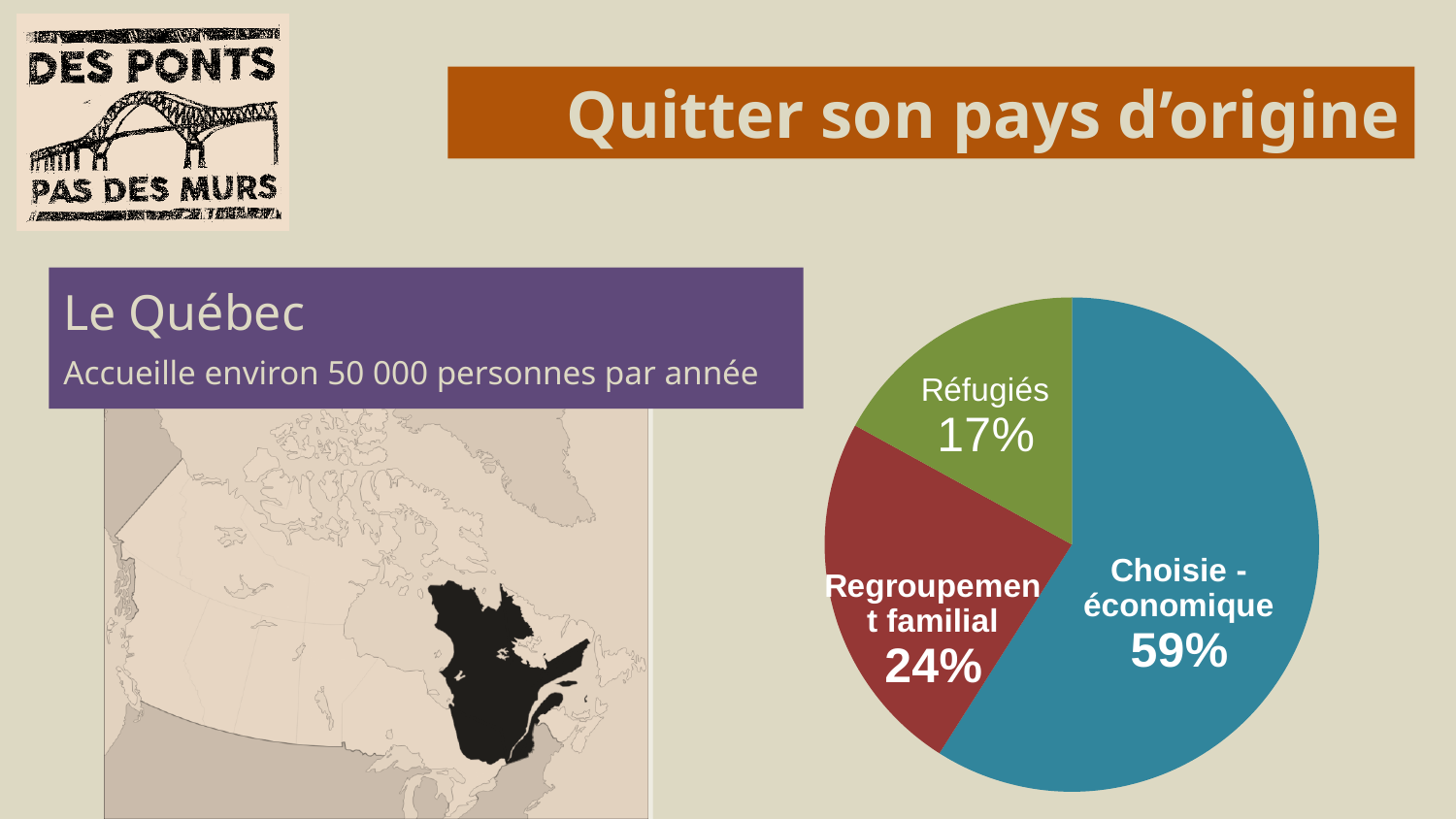
What share of the pie does the 'Réfugiés' slice represent? 17% What share of the pie does the 'Choisie - économique' slice represent? 59% What colour is the 'Choisie - économique' slice of the pie chart? blue What is the difference in percentage points between 'Regroupement familial' and 'Réfugiés'? 7 Which is larger, the 'Regroupement familial' slice or the 'Réfugiés' slice? Regroupement familial What kind of chart is shown on the slide? pie chart Which slice of the pie chart is the smallest? Réfugiés How many slices does the pie chart have? 3 What is the difference in percentage points between 'Choisie - économique' and 'Regroupement familial'? 35 What share of the pie does the 'Regroupement familial' slice represent? 24% What colour is the 'Réfugiés' slice of the pie chart? green Which slice of the pie chart is the largest? Choisie - économique